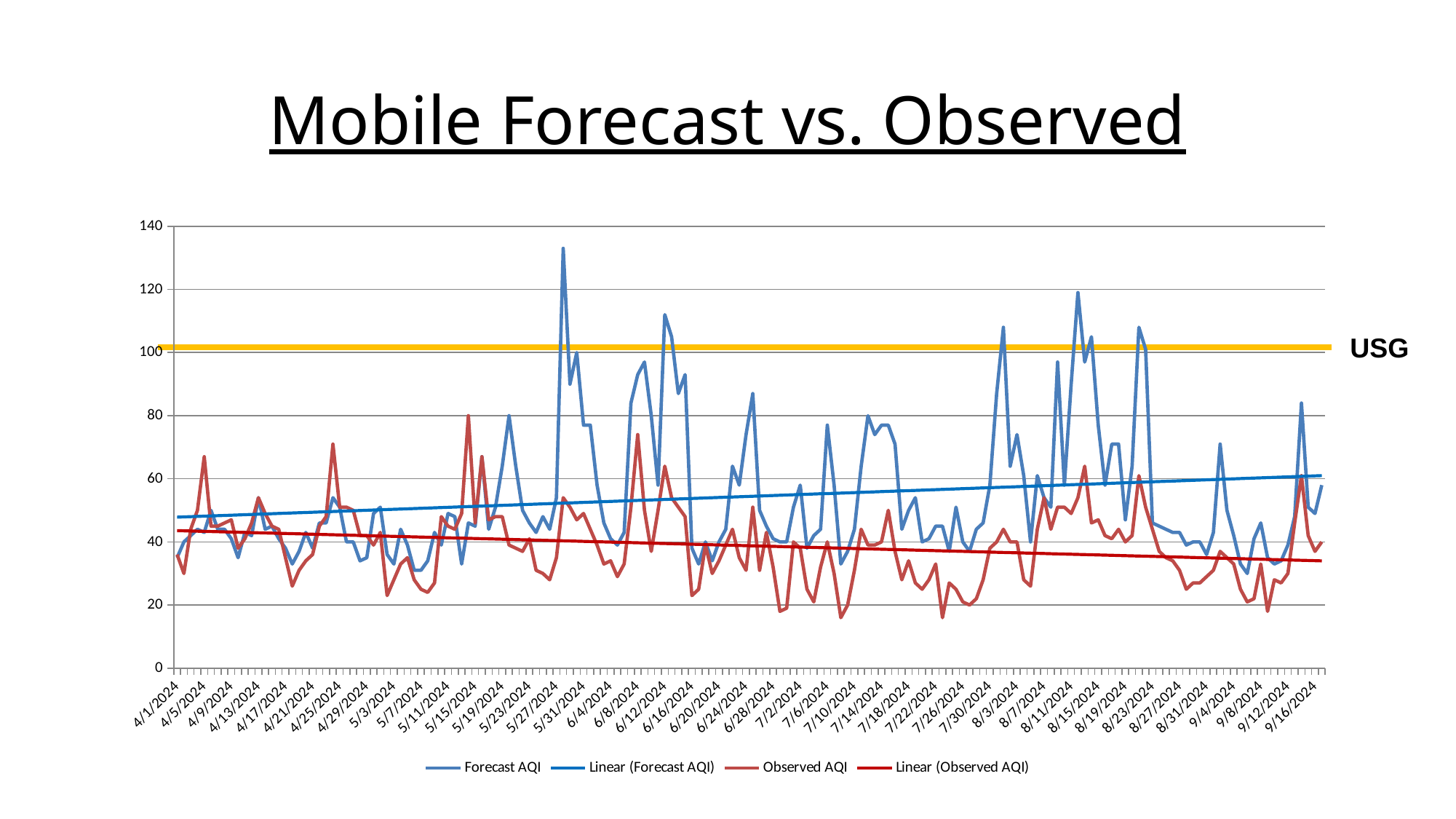
Which series reaches higher peak values, Forecast AQI or Observed AQI? Forecast AQI Is the highest value reached by the Observed AQI series greater or less than 100? less What kind of chart is shown on the slide? line chart At the right end of the chart, which trendline is higher, Linear (Forecast AQI) or Linear (Observed AQI)? Linear (Forecast AQI) Is the lowest value reached by the Observed AQI series greater or less than 20? less Does the Linear (Observed AQI) trendline rise or fall from left to right? fall What is the title of the chart on the slide? Mobile Forecast vs. Observed How many series does the chart legend list? 4 What label is attached to the yellow horizontal line on the chart? USG Does the Linear (Forecast AQI) trendline rise or fall from left to right? rise Is the USG line greater or less than 120 on the vertical axis? less